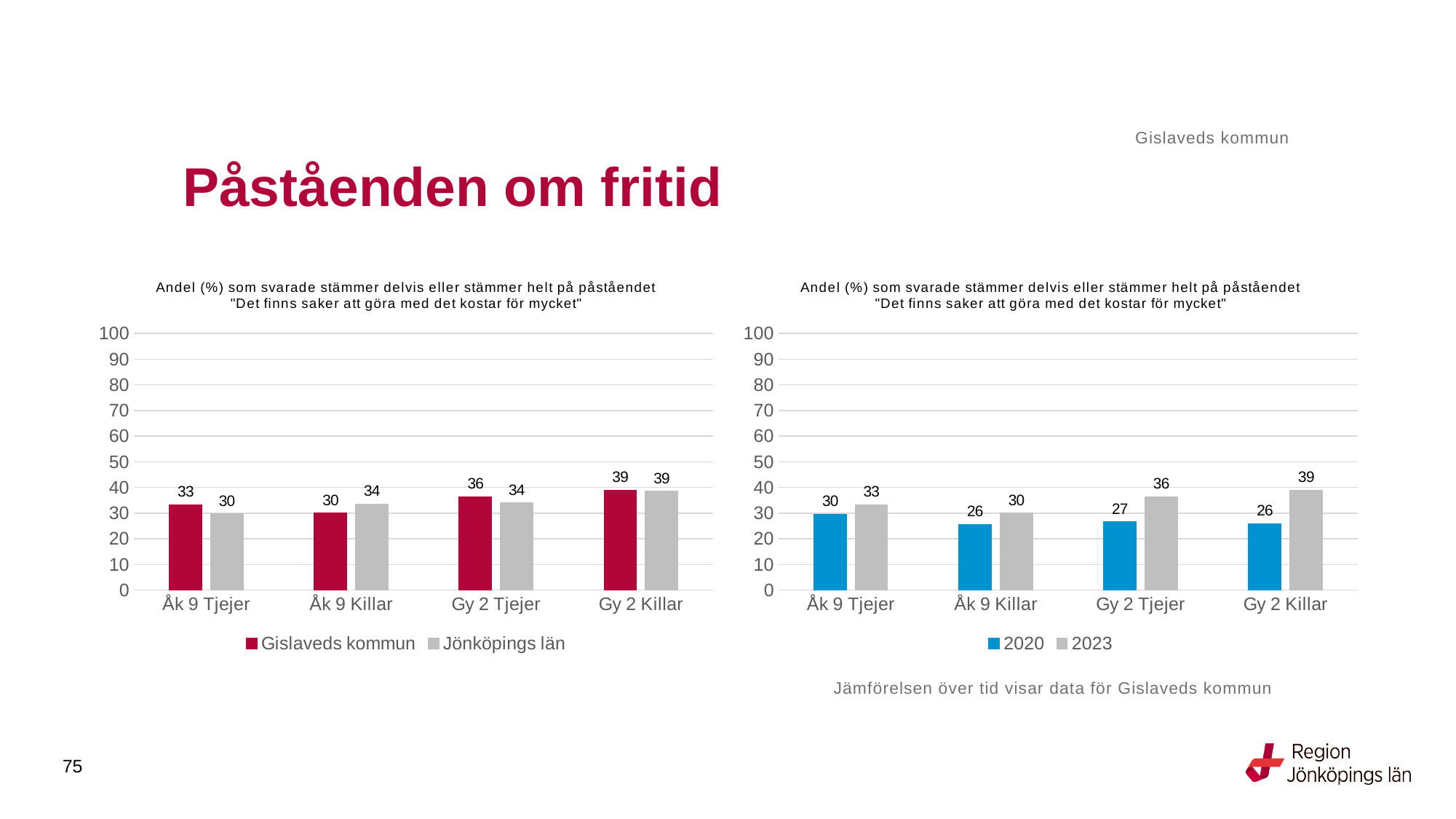
In the left chart, which is larger for Gy 2 Tjejer: Gislaveds kommun or Jönköpings län? Gislaveds kommun In the left chart, which category has the highest value for Gislaveds kommun? Gy 2 Killar In the right chart, what is the 2020 value for Gy 2 Tjejer? 27 In the right chart, how many series does the legend list? 2 In the right chart, what is the 2023 value for Gy 2 Killar? 39 In the left chart, what is the value for Jönköpings län for Åk 9 Killar? 34 In the right chart, which category has the lowest 2020 value? Åk 9 Killar and Gy 2 Killar (both 26) In the left chart, what is the value for Gislaveds kommun for Åk 9 Tjejer? 33 What kind of chart is the right chart? Bar chart In the left chart, what is the difference between Gislaveds kommun and Jönköpings län for Åk 9 Killar? 4 In the right chart, what is the difference between the 2023 and 2020 values for Gy 2 Killar? 13 How many categories are shown on the x axis of the left chart? 4